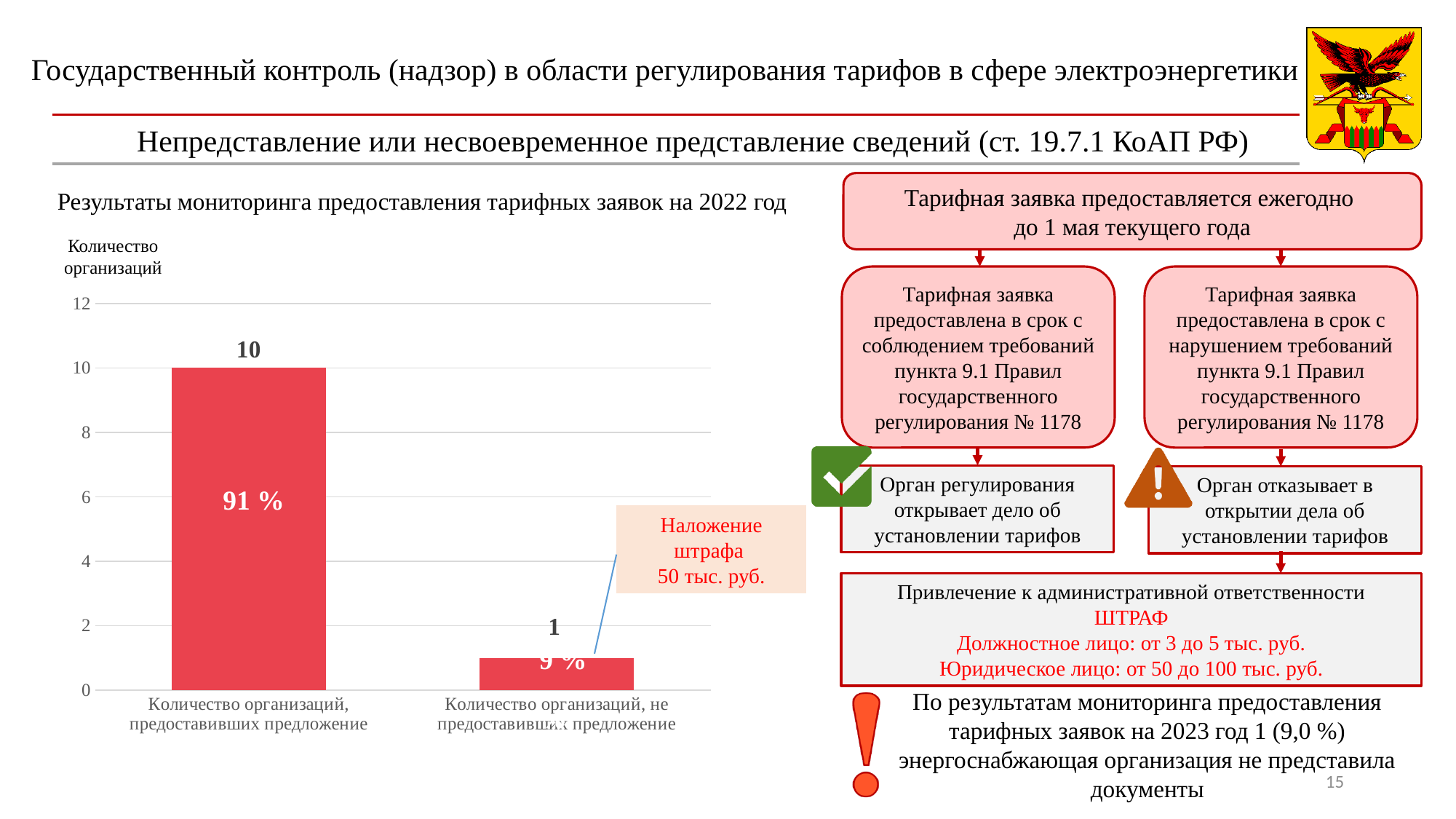
How many categories are plotted in the bar chart? 2 What type of chart is shown on the slide? Bar chart What is the label of the vertical axis of the chart? Количество организаций What is the difference between the number of organisations that submitted a proposal and those that did not? 9 Which category has the highest value in the chart? Количество организаций, предоставивших предложение What percentage label is printed on the bar for organisations that did not submit a proposal (не предоставивших предложение)? 9 % What is the title of the chart on the slide? Результаты мониторинга предоставления тарифных заявок на 2022 год Which category has the lowest value in the chart? Количество организаций, не предоставивших предложение How many organisations are shown for the category "Количество организаций, не предоставивших предложение"? 1 Which is larger: the number of organisations that submitted a proposal or the number that did not? Количество организаций, предоставивших предложение What percentage label is printed inside the bar for organisations that submitted a proposal (предоставивших предложение)? 91 % How many organisations are shown for the category "Количество организаций, предоставивших предложение"? 10